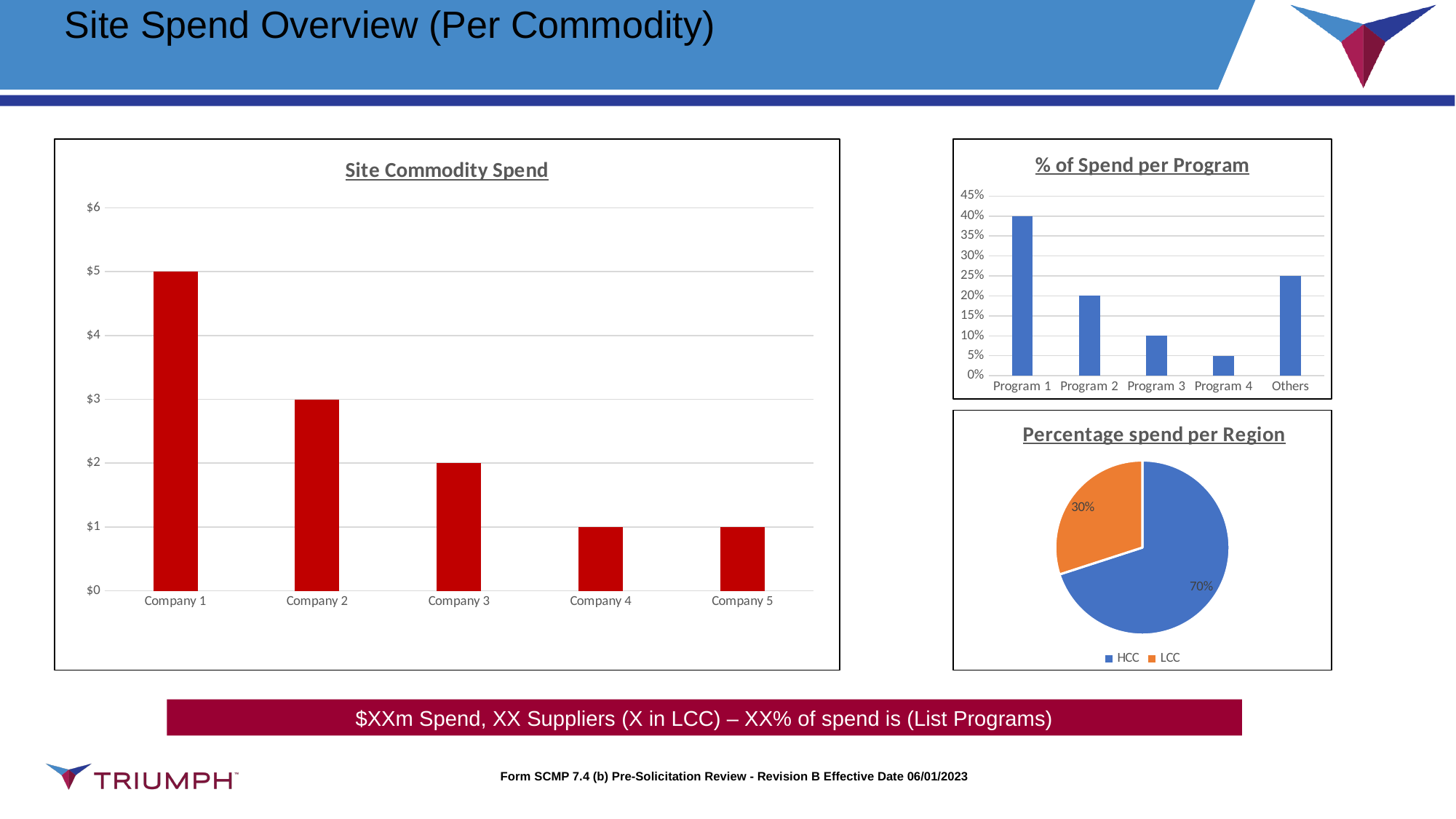
In the Site Commodity Spend chart, do the values rise or fall from Company 1 to Company 4? fall In the % of Spend per Program chart, which is larger, Program 2 or Others? Others In the % of Spend per Program chart, which program has the lowest share of spend? Program 4 In the Site Commodity Spend chart, which company has the highest spend? Company 1 In the Site Commodity Spend chart, how many companies are shown? 5 In the Percentage spend per Region chart, what share of spend is HCC? 70% In the Site Commodity Spend chart, what is the value for Company 1? $5 In the % of Spend per Program chart, what is the difference between Program 1 and Program 3? 30% What kind of chart is the Site Commodity Spend chart? bar chart In the % of Spend per Program chart, what is the value for Program 1? 40% How many entries does the legend of the Percentage spend per Region chart list? 2 In the Site Commodity Spend chart, what is the difference between Company 1 and Company 2? $2